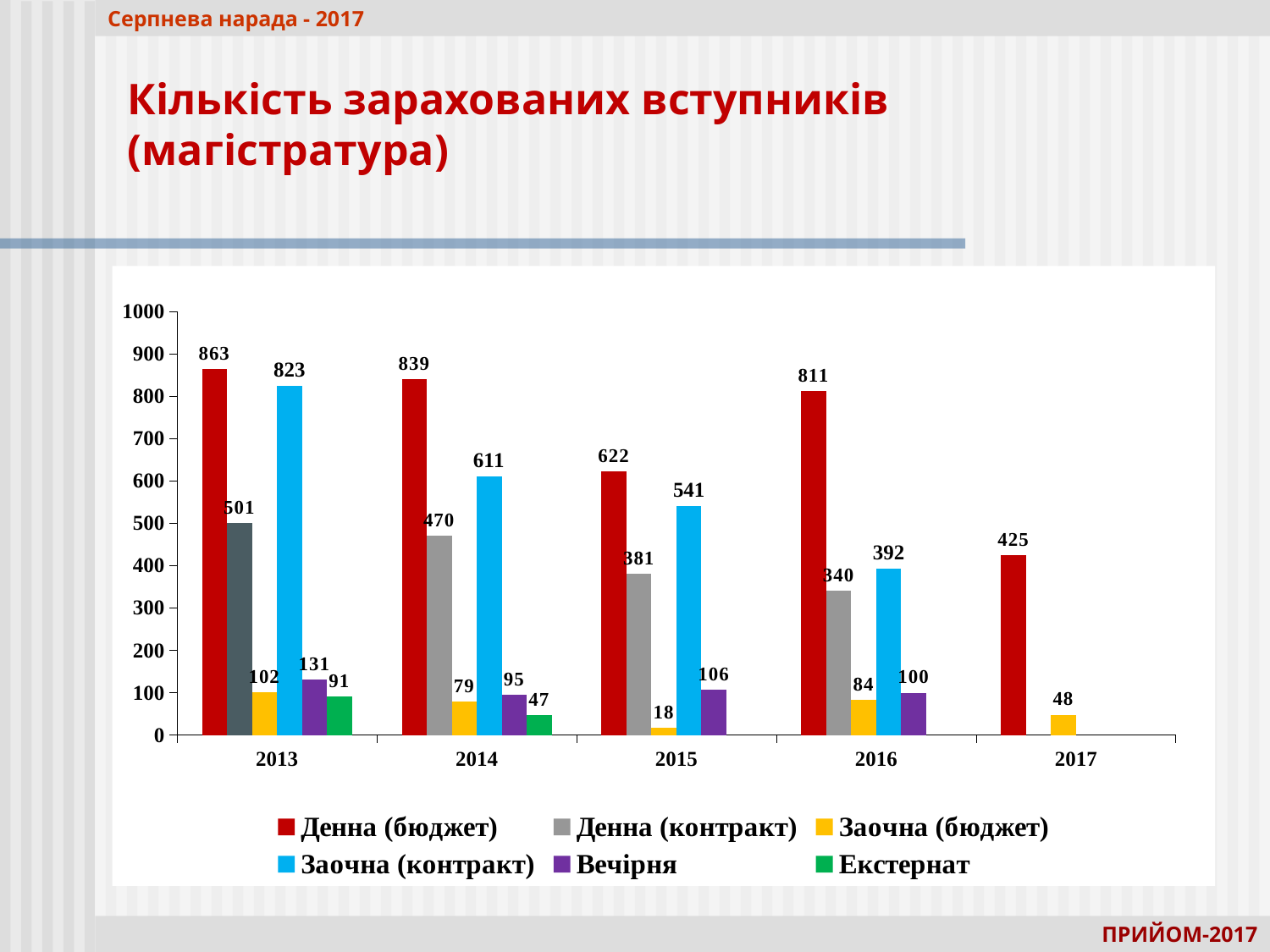
Which year has the highest value for Денна (бюджет)? 2013 What kind of chart is shown on the slide? Bar chart Which year has the lowest value for Заочна (бюджет)? 2015 Which is larger in 2014: Денна (контракт) or Заочна (контракт)? Заочна (контракт) What is the difference between Денна (бюджет) in 2016 and Денна (бюджет) in 2017? 386 How many years are shown on the x axis? 5 What is the value for Заочна (контракт) in 2014? 611 How many series does the legend list? 6 What is the value for Вечірня in 2016? 100 Does the value for Заочна (контракт) rise or fall from 2013 to 2016? Fall What is the value for Денна (бюджет) in 2013? 863 What is the value for Заочна (бюджет) in 2015? 18